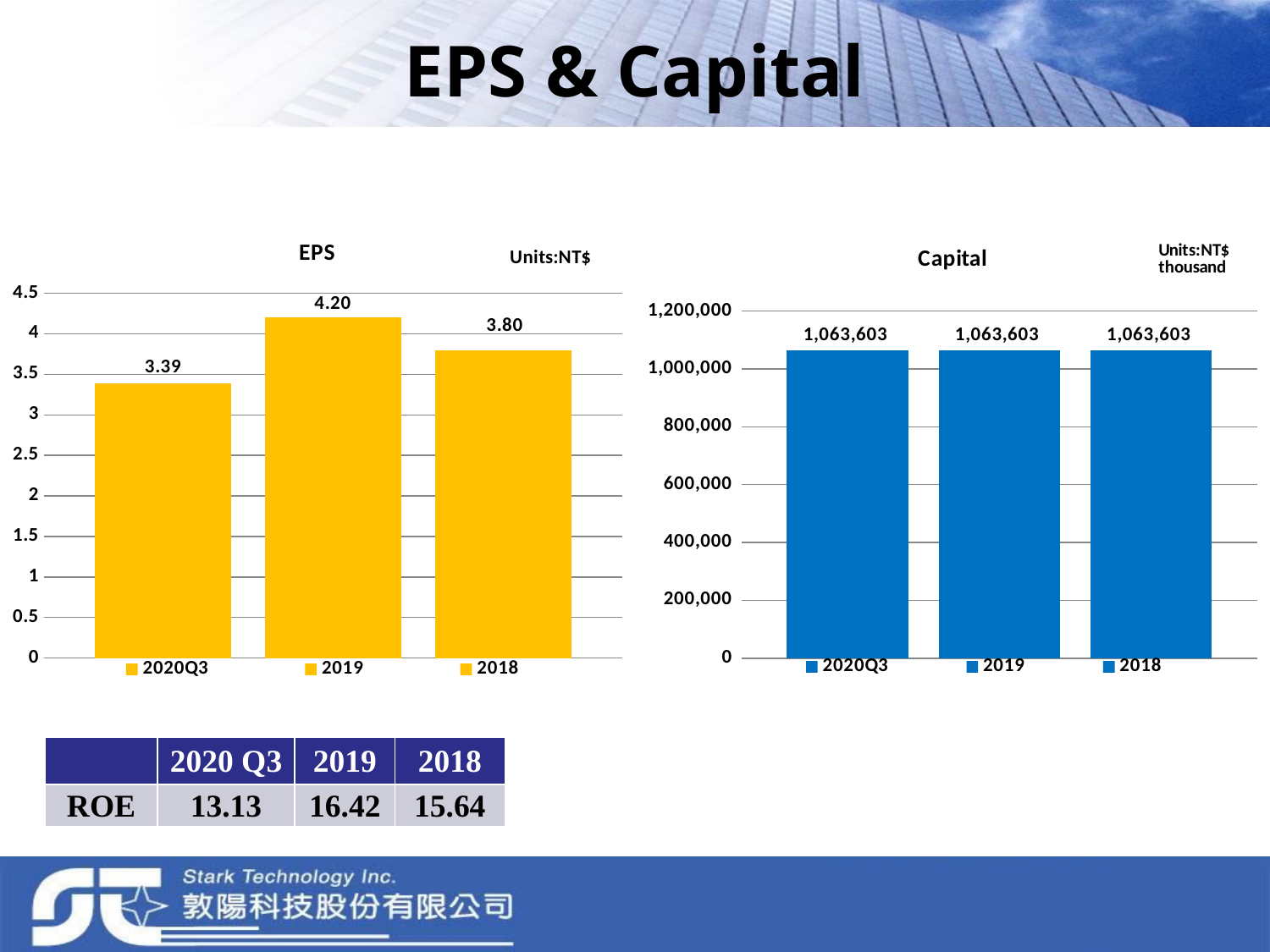
In the EPS chart, which category has the lowest value? 2020Q3 In the EPS chart, what is the value for 2020Q3? 3.39 In the EPS chart, which is larger, the value for 2018 or the value for 2020Q3? 2018 In the EPS chart, is the value for 2020Q3 greater or less than 3.5? less In the Capital chart, what is the value for 2018? 1,063,603 What kind of chart is the EPS chart? Bar chart In the EPS chart, what is the value for 2019? 4.20 In the Capital chart, is the value for 2019 greater or less than 1,000,000? greater In the EPS chart, what is the difference between the 2019 and 2018 values? 0.40 What units are shown for the Capital chart? NT$ thousand In the Capital chart, how many bars are plotted? 3 In the EPS chart, which category has the highest value? 2019